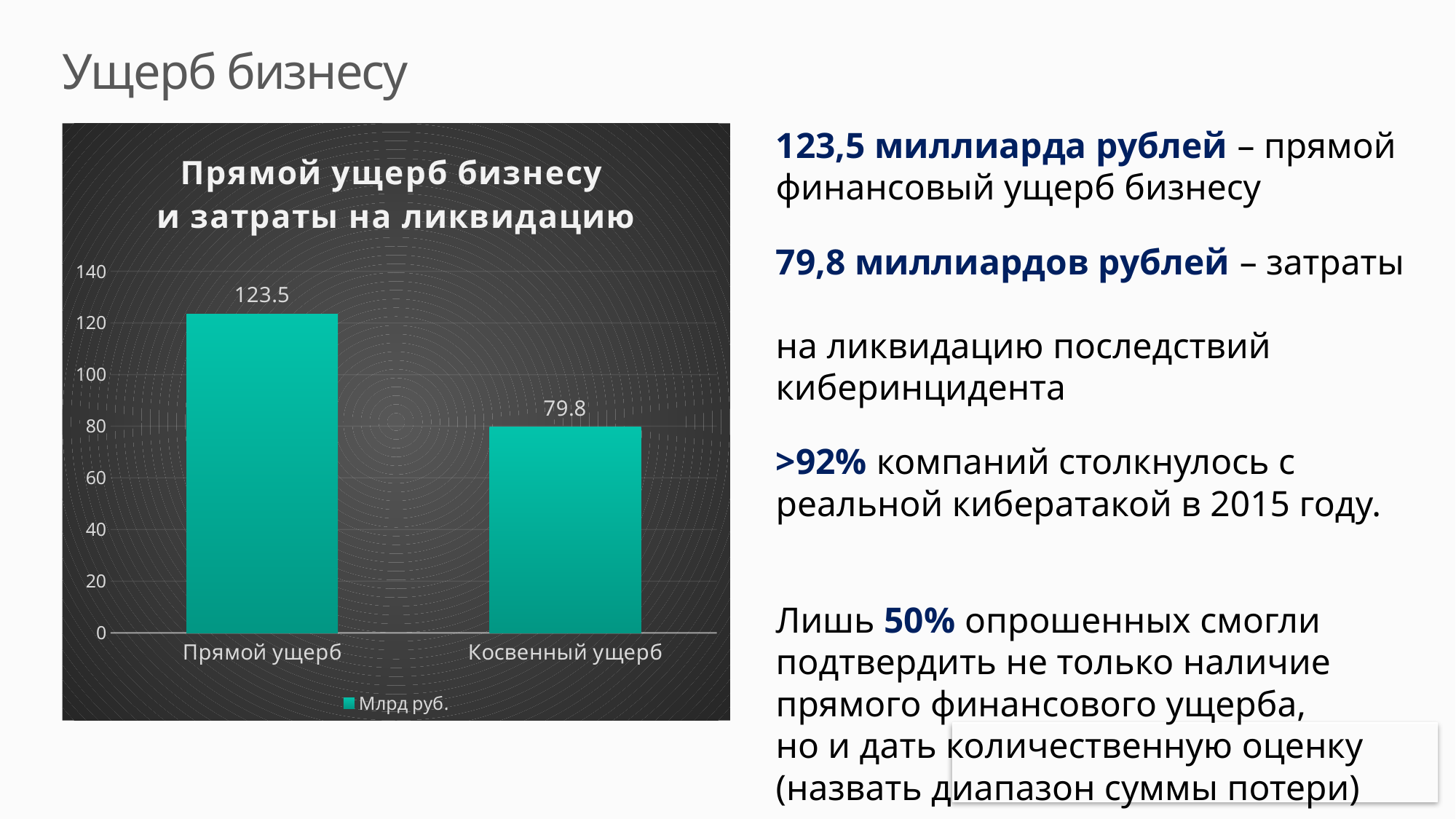
What is the title of the chart? Прямой ущерб бизнесу и затраты на ликвидацию How many categories are shown on the chart? 2 What is the value for Прямой ущерб? 123.5 Is the value for Прямой ущерб greater or less than 120? greater Which category has the highest value? Прямой ущерб How many series does the legend list? 1 Is the value for Косвенный ущерб greater or less than 100? less What is the value for Косвенный ущерб? 79.8 What is the difference between the values for Прямой ущерб and Косвенный ущерб? 43.7 Which category has the lowest value? Косвенный ущерб Which is larger, the value for Прямой ущерб or the value for Косвенный ущерб? Прямой ущерб What kind of chart is shown on the slide? bar chart